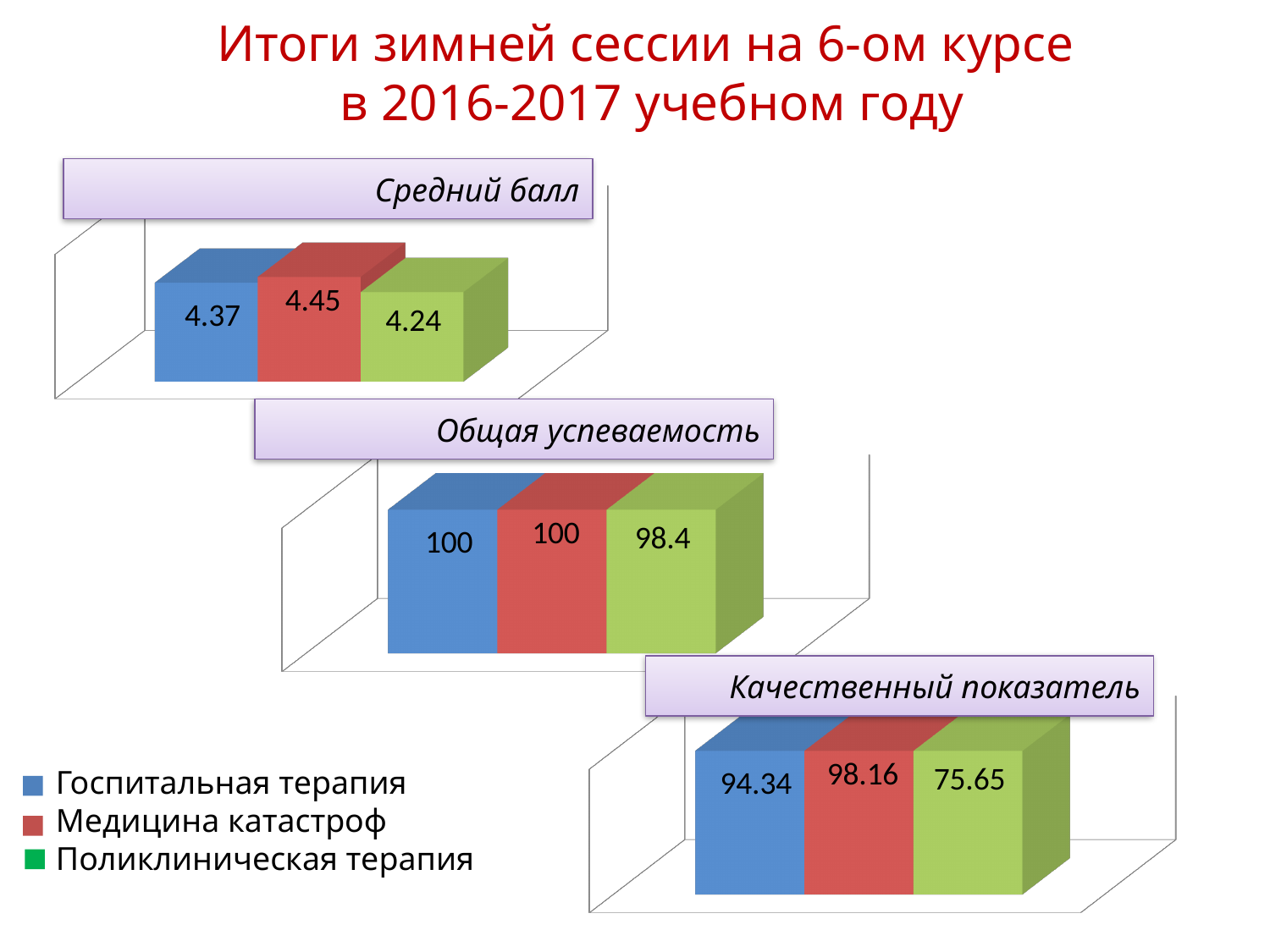
In the 'Качественный показатель' chart, what is the value for Поликлиническая терапия? 75.65 What kind of chart is the 'Средний балл' chart? Bar chart In the 'Общая успеваемость' chart, what is the value for Поликлиническая терапия? 98.4 Which discipline is shown in red in the legend? Медицина катастроф In the 'Средний балл' chart, what is the value for Медицина катастроф? 4.45 How many series does the legend list? 3 In the 'Качественный показатель' chart, which discipline has the highest value? Медицина катастроф In the 'Средний балл' chart, which discipline has the lowest value? Поликлиническая терапия In the 'Качественный показатель' chart, which is larger: the value for Госпитальная терапия or for Медицина катастроф? Медицина катастроф In the 'Качественный показатель' chart, what is the difference between the values for Госпитальная терапия and Поликлиническая терапия? 18.69 In the 'Общая успеваемость' chart, what is the value for Госпитальная терапия? 100 In the 'Средний балл' chart, what is the difference between the values for Медицина катастроф and Госпитальная терапия? 0.08